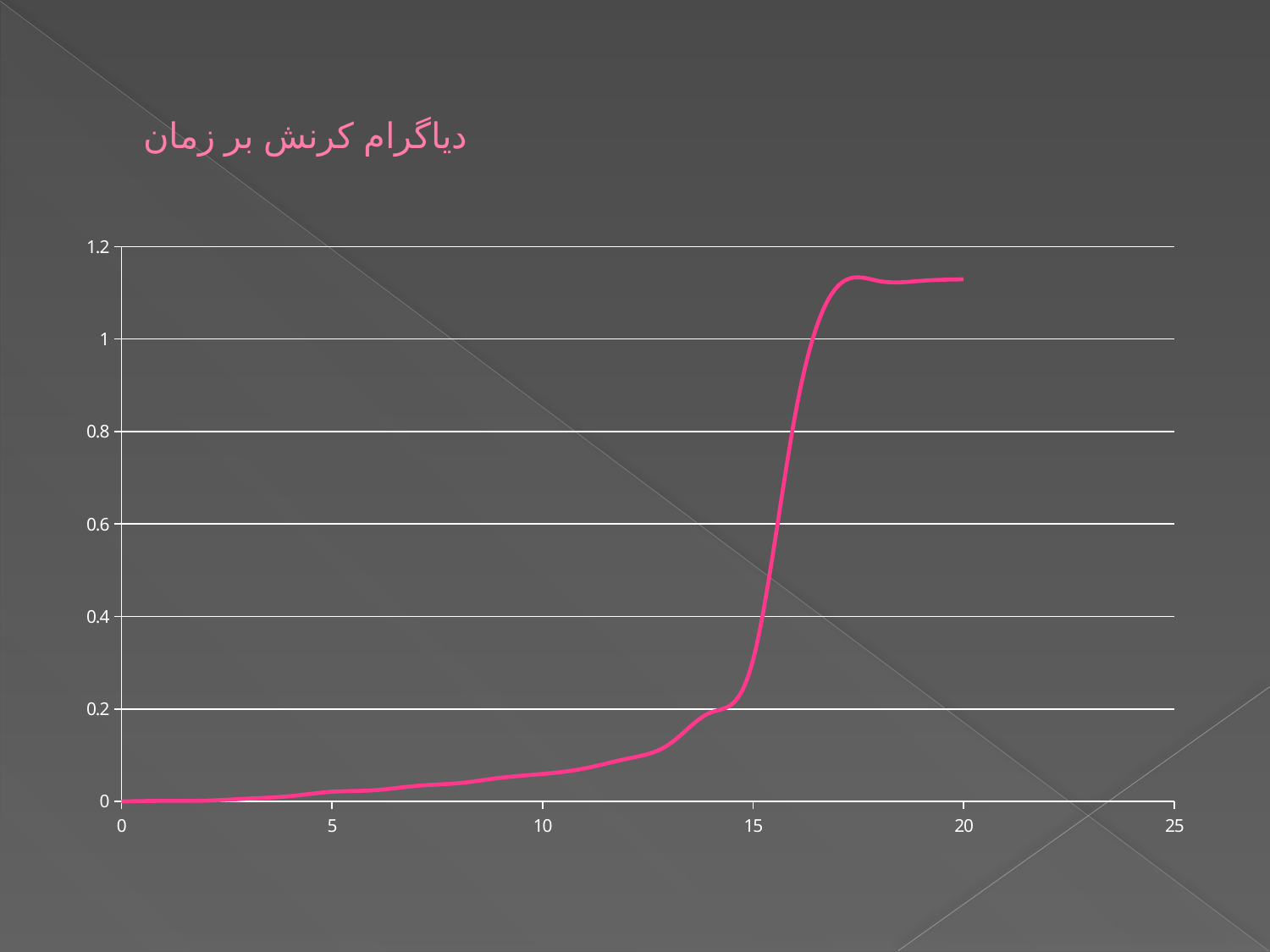
Which is larger, the value at x = 10 or the value at x = 20? x = 20 Is the value at x = 20 greater or less than 1? greater Is the value at x = 5 greater or less than 0.2? less Is the value at x = 15 greater or less than 0.6? less How many lines are plotted on the chart? 1 What kind of chart is shown on the slide? line chart Overall, does the plotted value rise or fall as the x value increases from 0 to 20? rise What is the title of the chart? دیاگرام کرنش بر زمان What is the highest value labelled on the y axis? 1.2 What colour is the plotted line? pink